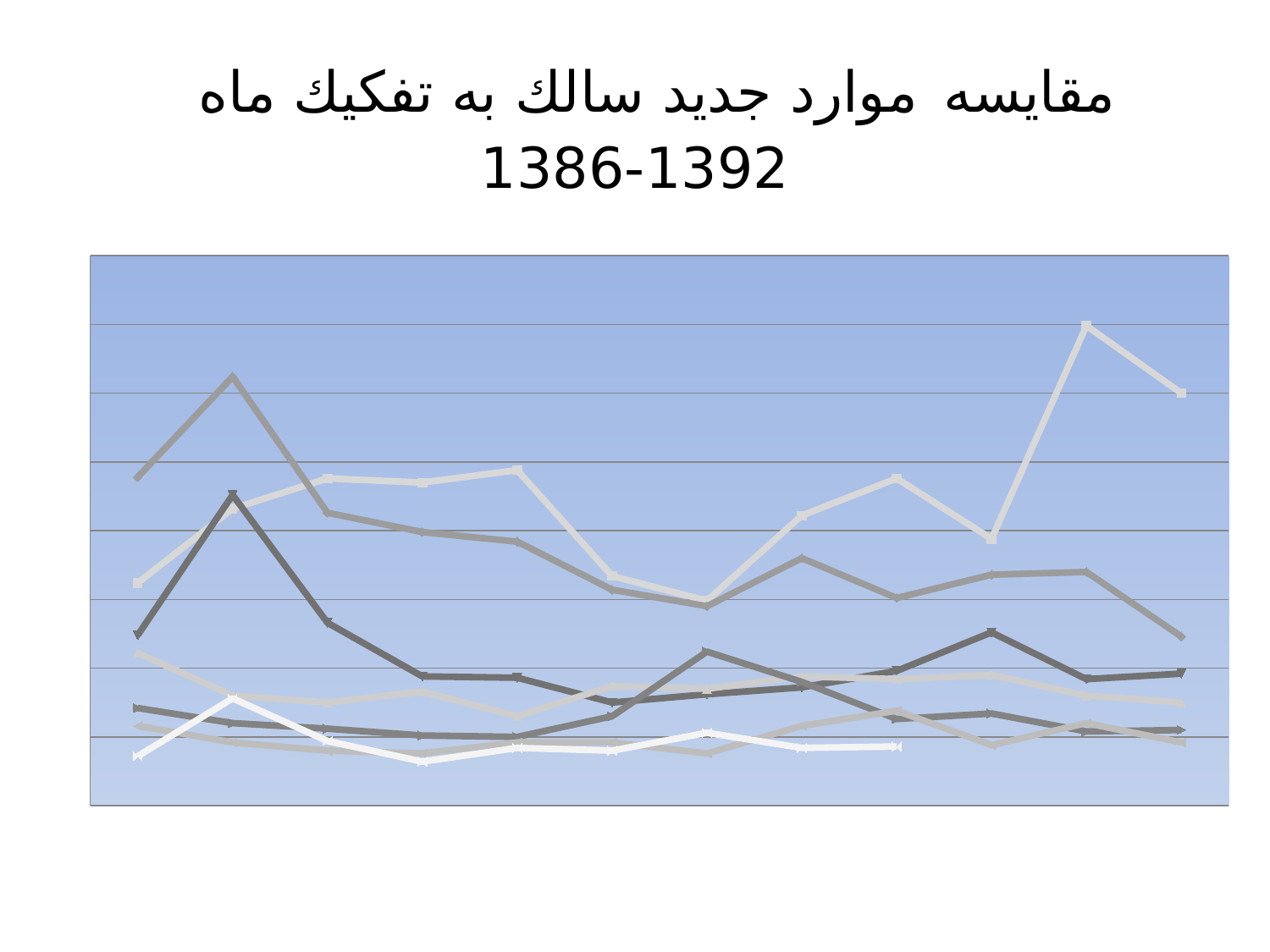
How many points along the x axis does each line in the chart have? 12 What kind of chart is shown on the slide? line chart Does the lightest line with square markers end higher or lower than it starts? higher Which range of years does the chart title refer to? 1386-1392 What is the title of the chart on the slide? مقايسه موارد جديد سالك به تفكيك ماه 1386-1392